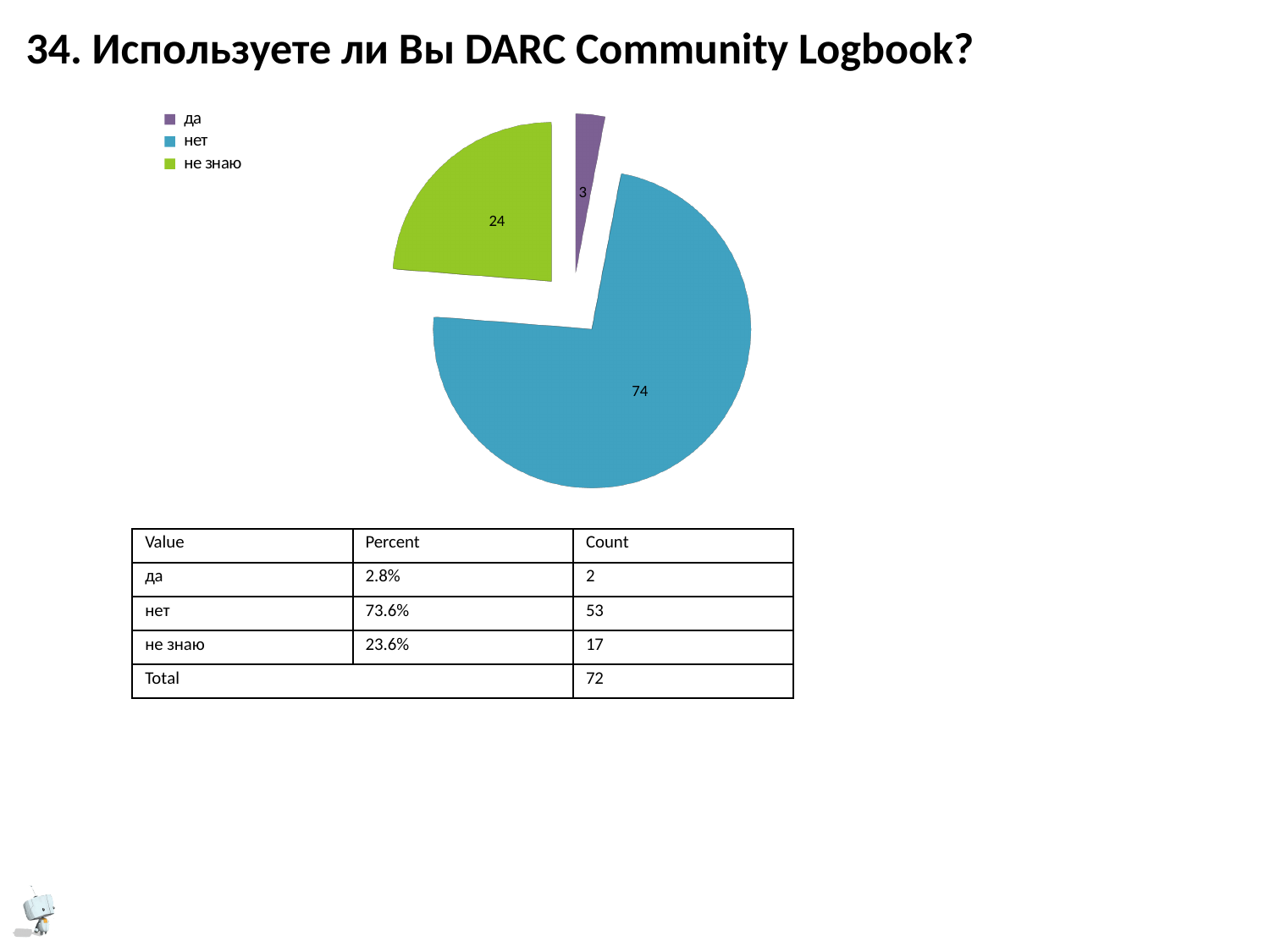
Which colour represents "нет" in the pie chart legend? blue Which category has the largest slice of the pie chart? нет What value is labelled on the pie slice for "да"? 3 According to the table, what percent of respondents answered "нет"? 73.6% Which slice is larger, "не знаю" or "да"? не знаю How many slices does the pie chart have? 3 What value is labelled on the pie slice for "не знаю"? 24 What is the difference between the labelled values for "нет" and "не знаю" on the pie chart? 50 What value is labelled on the pie slice for "нет"? 74 Which category has the smallest slice of the pie chart? да What kind of chart is shown on the slide? pie chart According to the table, what is the count for "не знаю"? 17